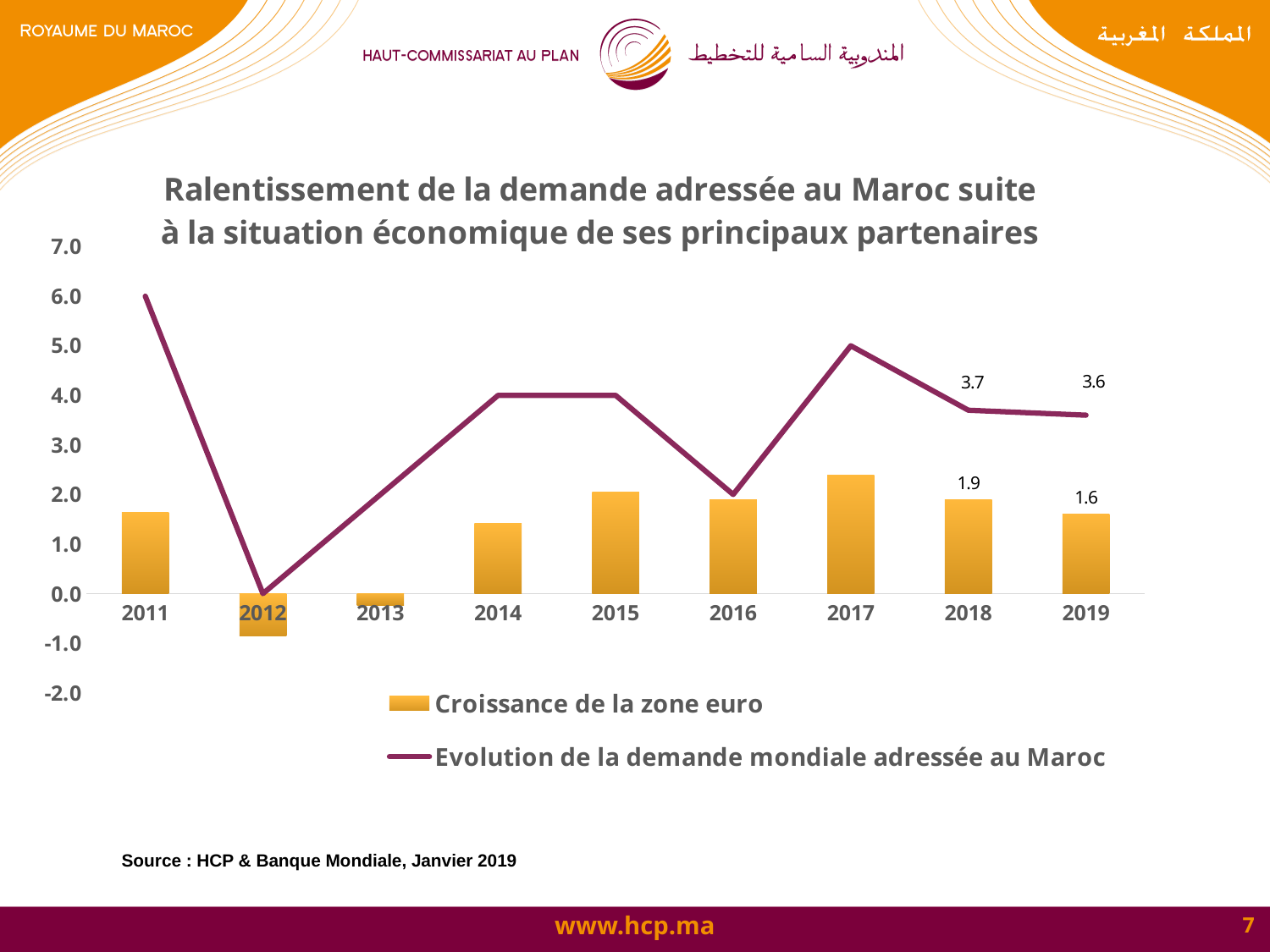
What is the value of Croissance de la zone euro in 2019? 1.6 What is the value of Croissance de la zone euro in 2018? 1.9 Is the value of Evolution de la demande mondiale adressée au Maroc in 2011 greater or less than 5.0? greater Is the value of Croissance de la zone euro in 2012 greater or less than 0.0? less How many series does the legend list? 2 What is the value of Evolution de la demande mondiale adressée au Maroc in 2018? 3.7 What is the difference between the Evolution de la demande mondiale adressée au Maroc values for 2018 and 2019? 0.1 How many years are shown on the x axis of the chart? 9 By how much does Croissance de la zone euro in 2018 exceed its value in 2019? 0.3 In which year is Croissance de la zone euro lowest? 2012 Does Evolution de la demande mondiale adressée au Maroc rise or fall from 2017 to 2019? fall In which year is Evolution de la demande mondiale adressée au Maroc highest? 2011